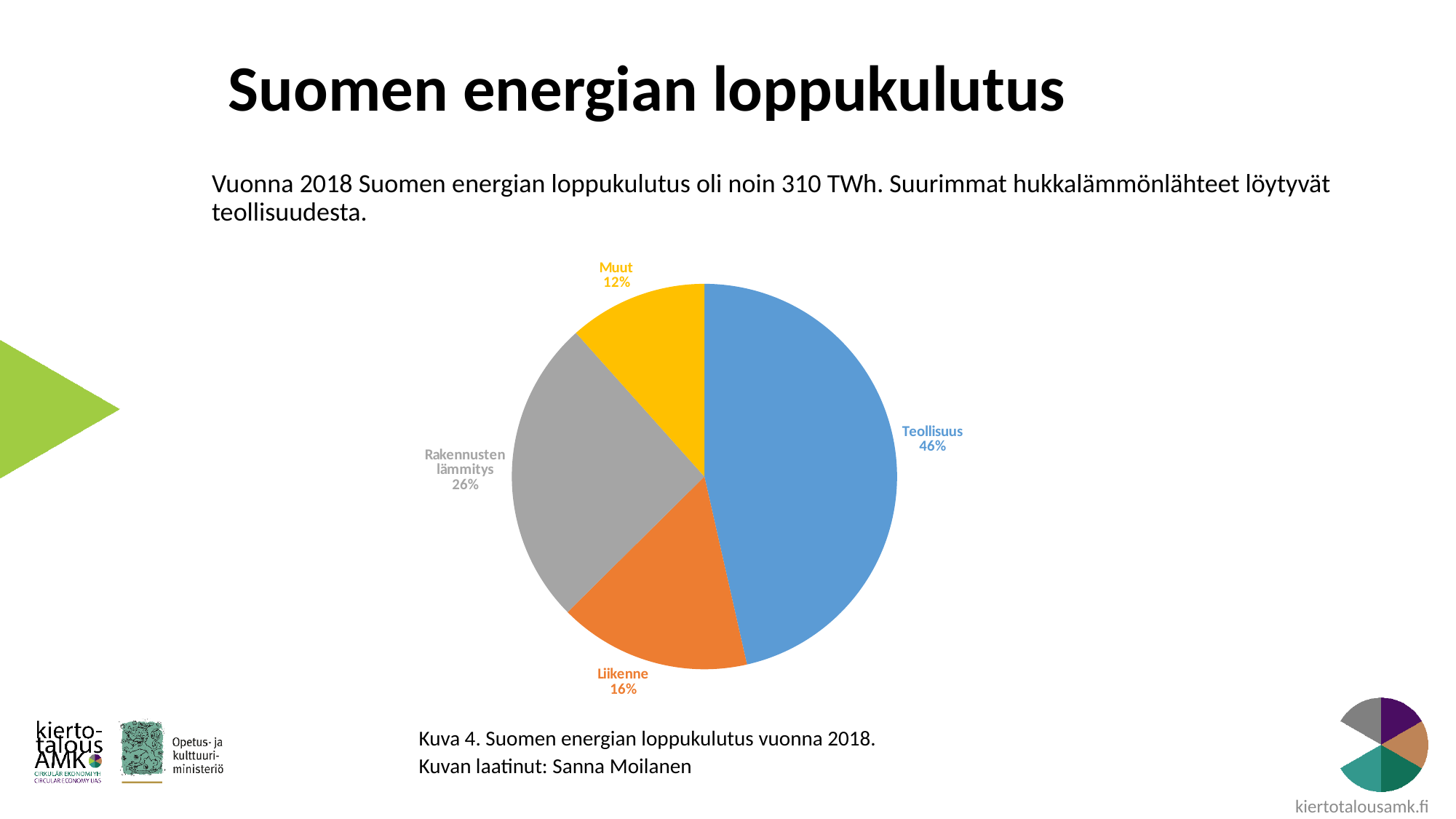
What is the difference in percentage points between Liikenne and Muut? 4 What colour is the Teollisuus slice? blue What share of the pie does Rakennusten lämmitys have? 26% What type of chart is shown on the slide? pie chart Which is larger, the share for Liikenne or the share for Muut? Liikenne What share of the pie does Liikenne have? 16% Which category has the largest slice of the pie? Teollisuus Which category has the smallest slice of the pie? Muut What share of the pie does Muut have? 12% What is the difference in percentage points between Teollisuus and Rakennusten lämmitys? 20 How many slices does the pie chart have? 4